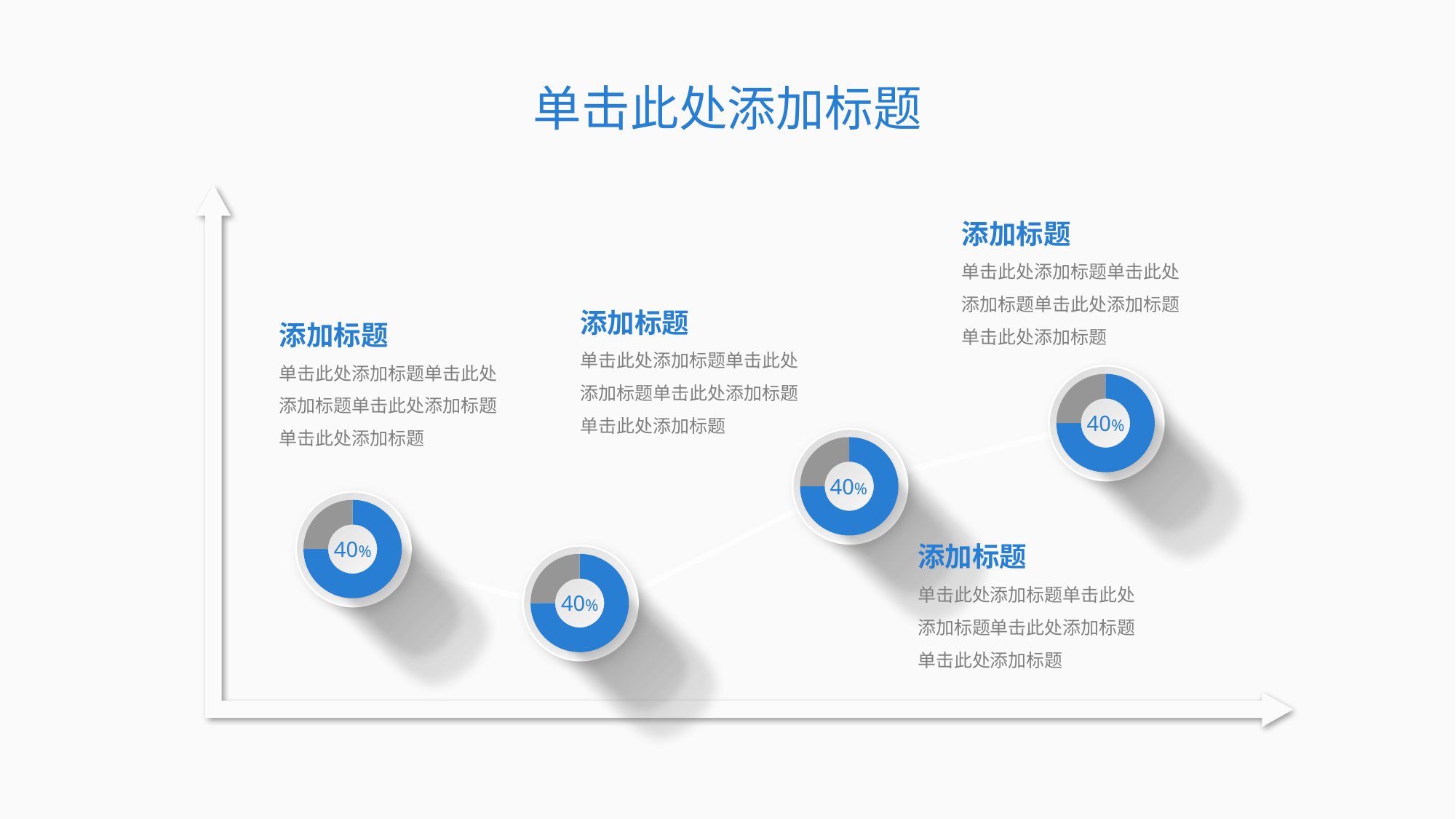
What value is printed in the centre of the leftmost donut chart? 40% What value is printed in the centre of the third donut chart from the left? 40% What value is printed in the centre of the second donut chart from the left? 40% What kind of chart is each of the four small circular charts on the slide? Donut chart What is the difference between the value in the leftmost donut chart and the value in the rightmost donut chart? 0% What colour is the filled (highlighted) portion of each donut chart? Blue What colour is the remaining (unfilled) portion of each donut chart? Grey Do all four donut charts on the slide show the same percentage value? Yes How many donut charts are shown on the slide? 4 What value is printed in the centre of the rightmost donut chart? 40%